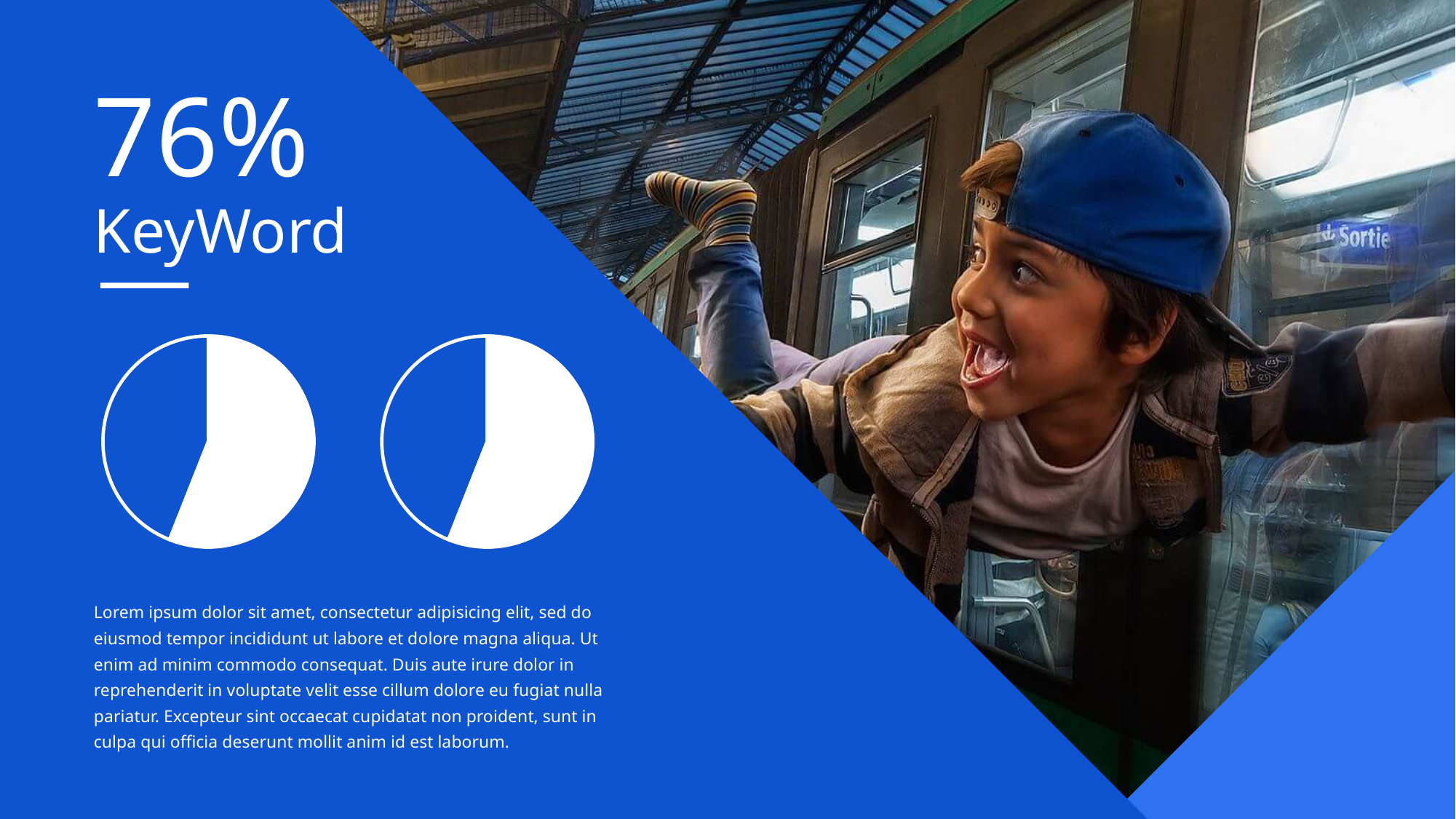
In the right pie chart, which slice is larger, the white slice or the blue slice? the white slice What two colours are used for the slices in the pie charts? white and blue In the left pie chart, which slice is larger, the white slice or the blue slice? the white slice Does either pie chart on the slide show a legend? No How many slices does the right pie chart have? 2 What kind of chart is the right chart on the slide? pie chart How many slices does the left pie chart have? 2 How many pie charts are shown on the slide? 2 What kind of chart is the left chart on the slide? pie chart